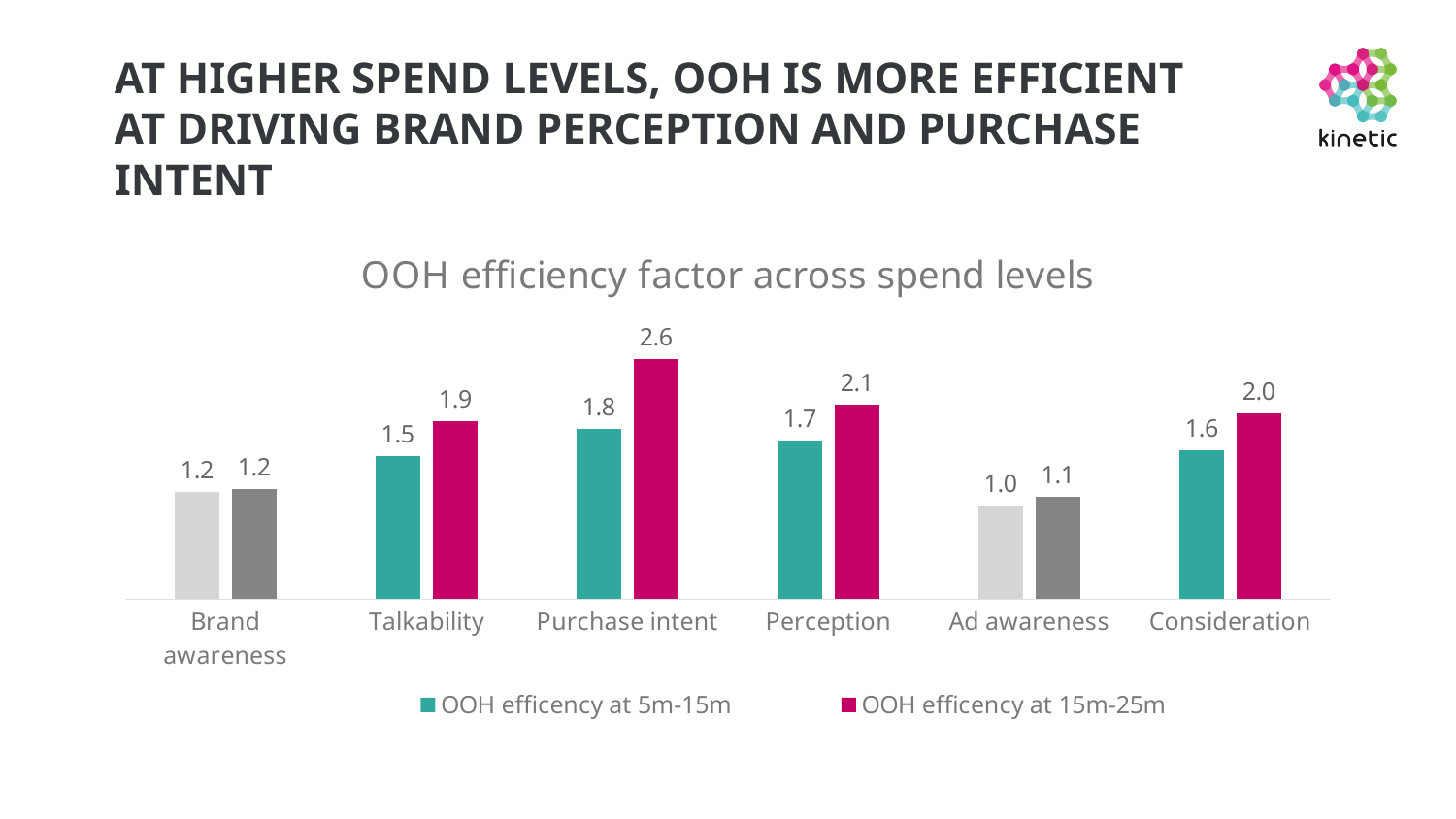
What is the OOH efficiency at 5m-15m for Talkability? 1.5 Which category has the lowest OOH efficiency at 5m-15m? Ad awareness What is the difference between the 15m-25m and 5m-15m efficiency values for Purchase intent? 0.8 What is the difference between the 15m-25m and 5m-15m efficiency values for Perception? 0.4 What is the OOH efficiency at 15m-25m for Purchase intent? 2.6 Which is larger for Talkability: the efficiency at 5m-15m or at 15m-25m? 15m-25m How many series does the legend list? 2 What is the OOH efficiency at 15m-25m for Consideration? 2.0 What is the title of the chart? OOH efficiency factor across spend levels How many categories are shown on the x axis of the chart? 6 Which category has the highest OOH efficiency at 15m-25m? Purchase intent What type of chart is shown on the slide? Bar chart